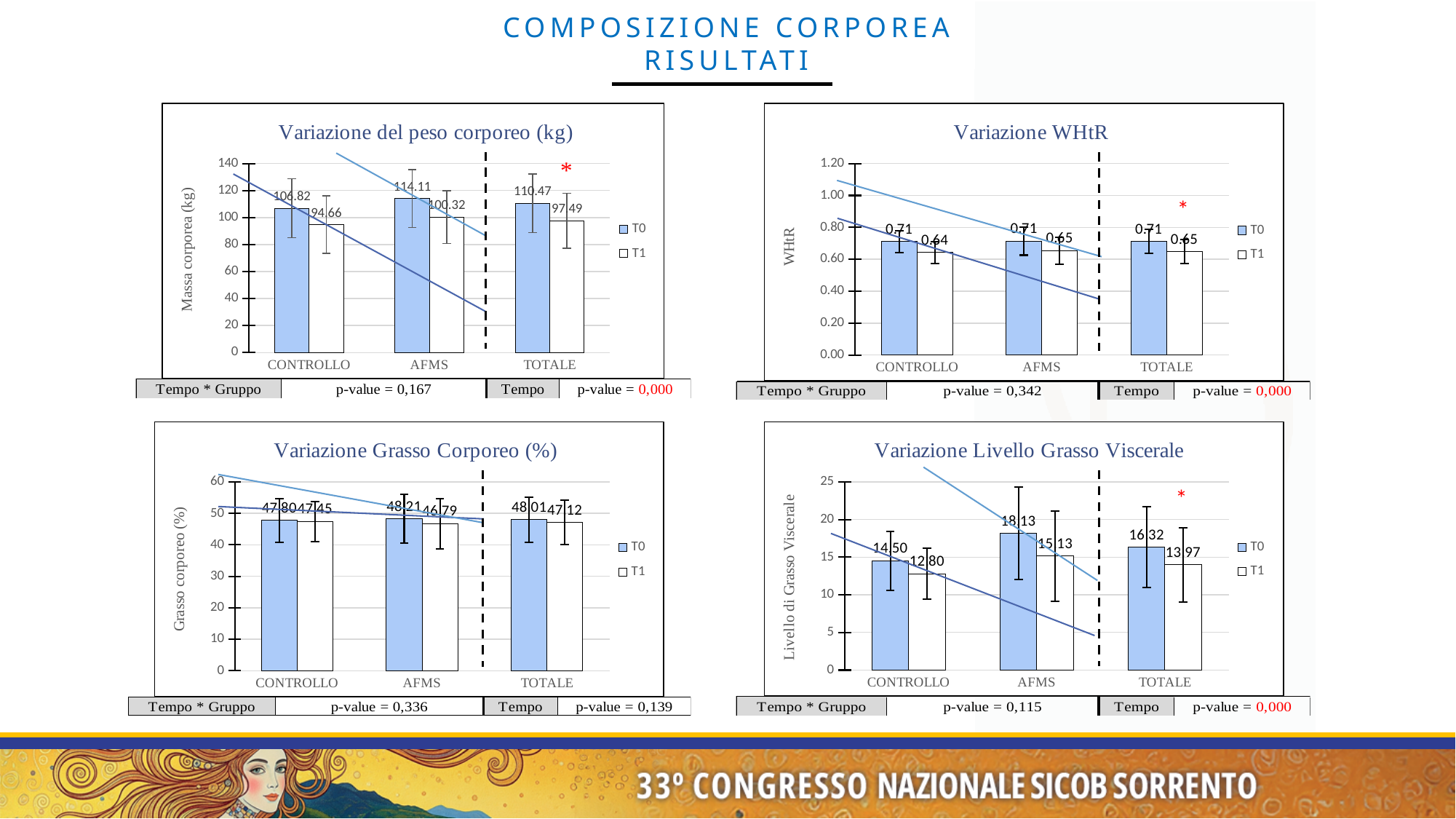
In the chart titled "Variazione Grasso Corporeo (%)", which category has the lowest T1 value? AFMS In the chart titled "Variazione del peso corporeo (kg)", what is the T0 value for AFMS? 114.11 In the chart titled "Variazione WHtR", how many series does the legend list? 2 In the chart titled "Variazione WHtR", what is the T1 value for CONTROLLO? 0.64 In the chart titled "Variazione Livello Grasso Viscerale", is the T0 value for CONTROLLO larger or the T1 value for AFMS? T1 value for AFMS In the chart titled "Variazione Livello Grasso Viscerale", which category has the highest T0 value? AFMS In the chart titled "Variazione Livello Grasso Viscerale", how many categories are shown on the x axis? 3 In the chart titled "Variazione Livello Grasso Viscerale", what is the T0 value for AFMS? 18.13 What kind of chart is the chart titled "Variazione del peso corporeo (kg)"? Bar chart In the chart titled "Variazione del peso corporeo (kg)", what is the T1 value for TOTALE? 97.49 In the chart titled "Variazione del peso corporeo (kg)", what is the difference between the T0 and T1 values for CONTROLLO? 12.16 In the chart titled "Variazione Grasso Corporeo (%)", what is the T0 value for AFMS? 48.21